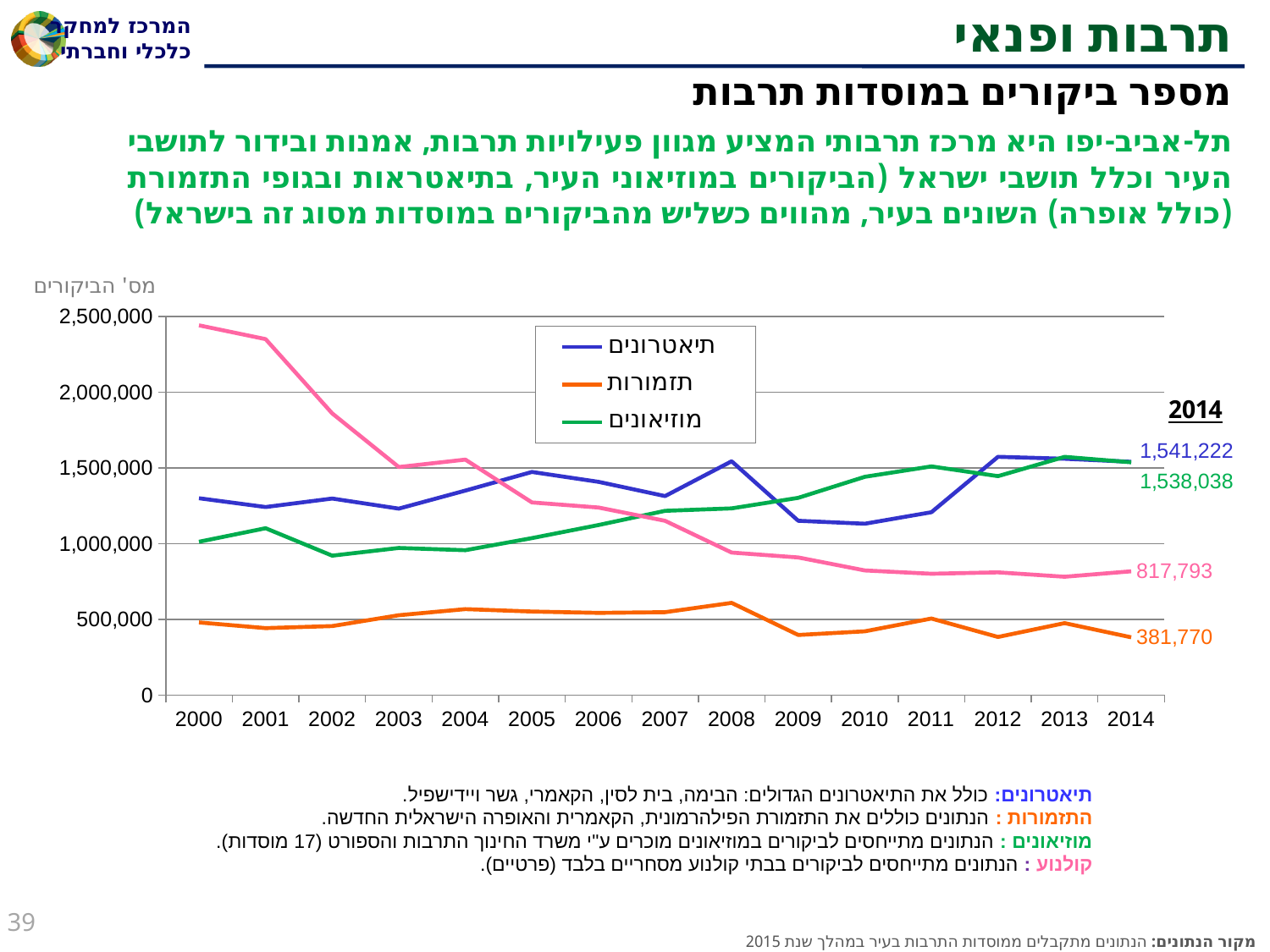
Which is larger for תיאטרונים: the value in 2008 or the value in 2009? 2008 Is the value of the מוזיאונים line in 2002 greater or less than 1,000,000? less What is the number of visits to תיאטרונים in 2014? 1,541,222 What is the number of visits to מוזיאונים in 2014? 1,538,038 How many series does the chart legend list? 3 Which of the labeled series has the lowest value in 2014? תזמורות What is the number of visits to תזמורות in 2014? 381,770 What type of chart is shown on the slide? line chart How many years are shown on the x axis of the chart? 15 What is the difference between the 2014 values for תיאטרונים and מוזיאונים? 3,184 What is the difference between the 2014 values for תיאטרונים and תזמורות? 1,159,452 Does the pink line rise or fall overall from 2000 to 2014? fall